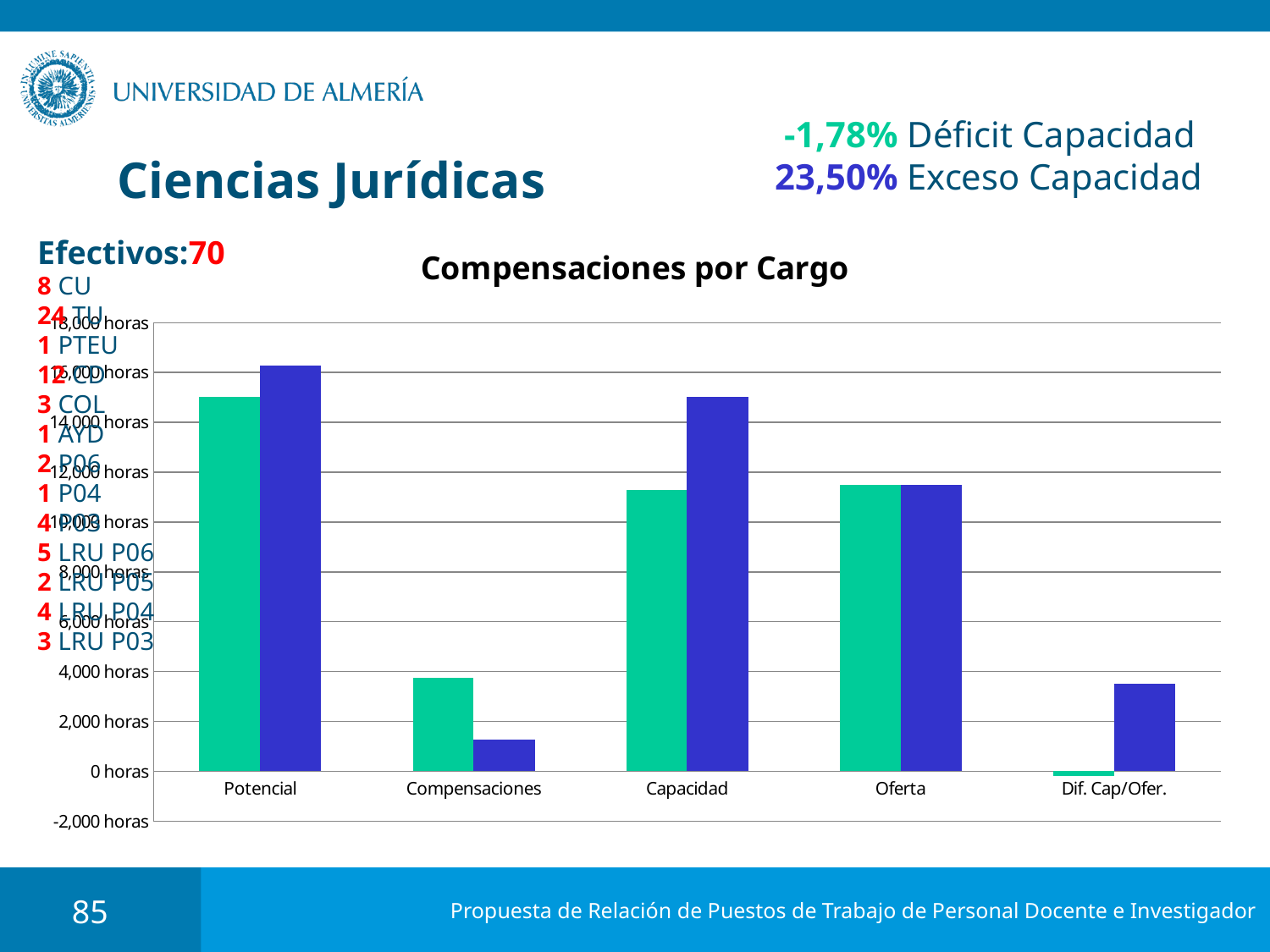
Which category has the lowest green bar? Dif. Cap/Ofer. Is the green bar for Potencial greater or less than 14,000 horas? greater What kind of chart is shown on the slide? bar chart How many categories are shown on the x axis of the chart? 5 For Capacidad, which bar is taller, the green one or the blue one? the blue one What is the title of the chart? Compensaciones por Cargo Which category has the tallest blue bar? Potencial Is the blue bar for Capacidad greater or less than 14,000 horas? greater Which is taller, the green bar for Potencial or the green bar for Compensaciones? Potencial Which category has the shortest blue bar? Compensaciones Which category has the tallest green bar? Potencial